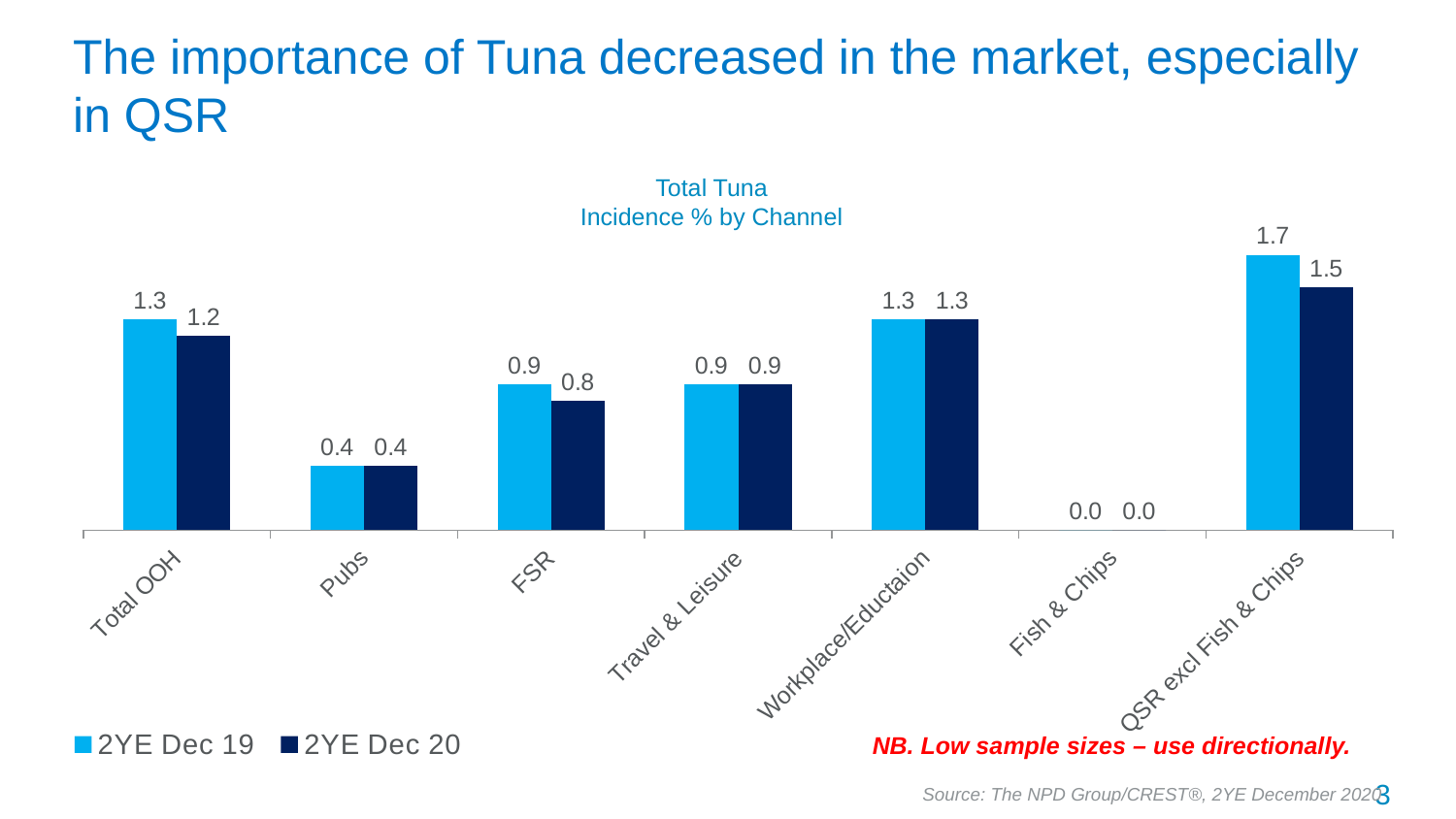
What is the Total Tuna incidence % for Total OOH in 2YE Dec 20? 1.2 Which series is shown in dark navy blue? 2YE Dec 20 What is the title of the chart? Total Tuna Incidence % by Channel What kind of chart is shown on the slide? Bar chart How many channels are shown on the x axis? 7 What is the difference between the 2YE Dec 19 and 2YE Dec 20 values for QSR excl Fish & Chips? 0.2 Which channel has the highest incidence % in 2YE Dec 19? QSR excl Fish & Chips What is the value for QSR excl Fish & Chips in 2YE Dec 19? 1.7 What is the value for Pubs in 2YE Dec 20? 0.4 Which channel has the lowest incidence % in 2YE Dec 20? Fish & Chips How many series does the legend list? 2 Which is larger for FSR: the 2YE Dec 19 value or the 2YE Dec 20 value? 2YE Dec 19